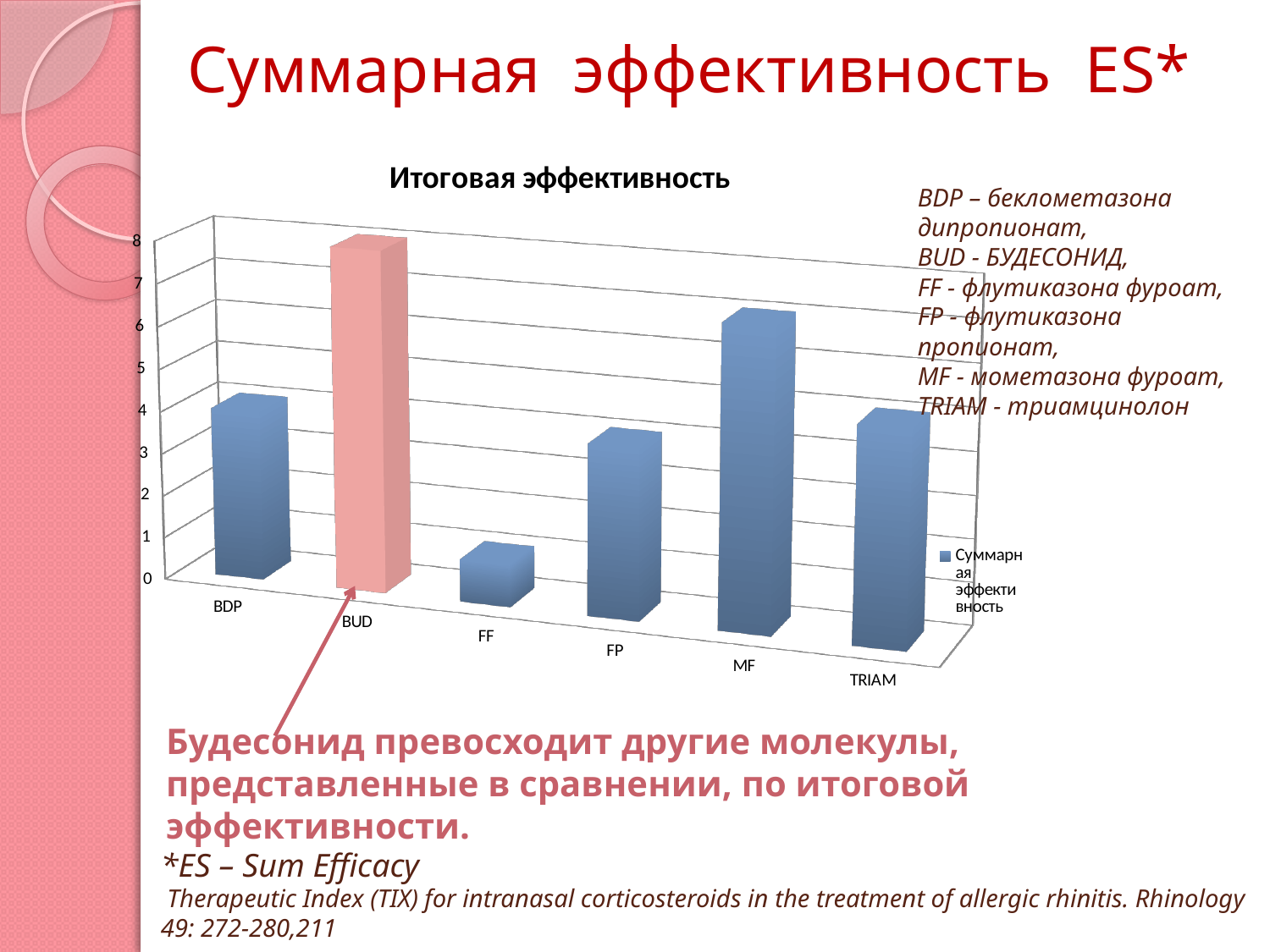
Is the value for FF greater or less than 2? less What kind of chart is shown on the slide? bar chart Which has the larger value, MF or FP? MF Which category has the lowest bar in the chart? FF Which has the larger value, BUD or BDP? BUD Which category has the highest bar in the chart? BUD Is the value for BUD greater or less than 6? greater How many series does the chart legend list? 1 Is the value for MF greater or less than 5? greater What is the title of the chart? Итоговая эффективность How many categories are plotted on the x axis of the chart? 6 Which bar is coloured differently (pink) from the others? BUD